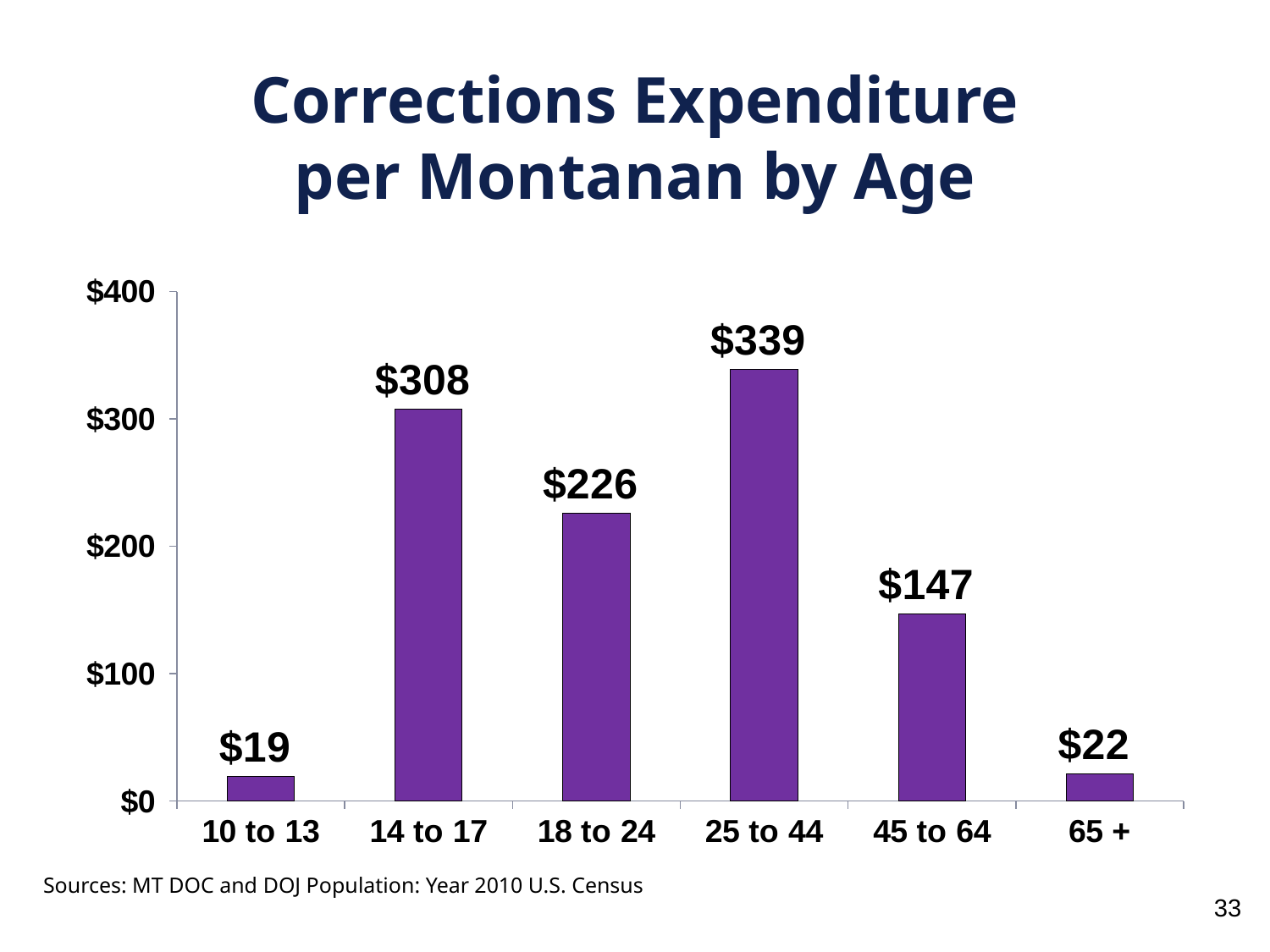
Is the corrections expenditure for the 45 to 64 age group greater or less than $200? less What kind of chart is shown on the slide? Bar chart Which age group has a higher corrections expenditure per Montanan, 14 to 17 or 18 to 24? 14 to 17 What is the corrections expenditure per Montanan for the 10 to 13 age group? $19 What is the corrections expenditure per Montanan for the 25 to 44 age group? $339 Which age group has the lowest corrections expenditure per Montanan? 10 to 13 What is the corrections expenditure per Montanan for the 45 to 64 age group? $147 What is the difference between the corrections expenditure for the 25 to 44 group and the 14 to 17 group? $31 Which age group has the highest corrections expenditure per Montanan? 25 to 44 What is the title of the chart on the slide? Corrections Expenditure per Montanan by Age How many age groups are shown in the chart? 6 What is the difference between the corrections expenditure for the 18 to 24 group and the 45 to 64 group? $79